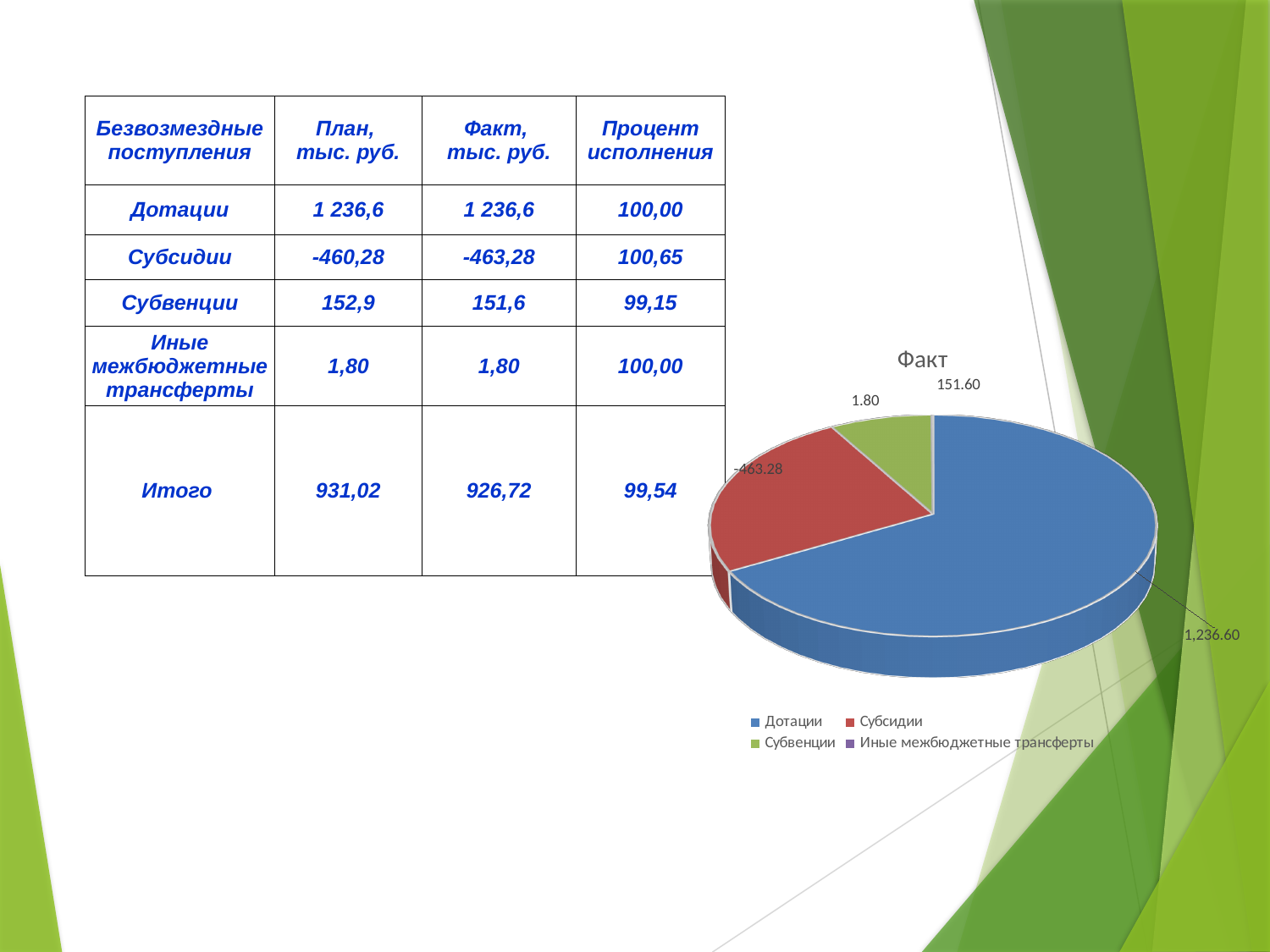
What value is labelled for Иные межбюджетные трансферты in the pie chart? 1.80 What value is labelled for Субвенции in the pie chart? 151.60 How many categories does the pie chart legend list? 4 What is the difference between the labelled values for Дотации and Субвенции in the pie chart? 1,085.00 What is the title of the pie chart? Факт Which category has the largest value in the pie chart? Дотации Is the labelled value for Субвенции in the pie chart greater or less than 100? greater Which is larger in the pie chart, the value for Дотации or the value for Субвенции? Дотации What colour is the Дотации slice in the pie chart? blue What type of chart is shown on the slide? pie chart What value is labelled for Дотации in the pie chart? 1,236.60 What value is labelled for Субсидии in the pie chart? -463.28